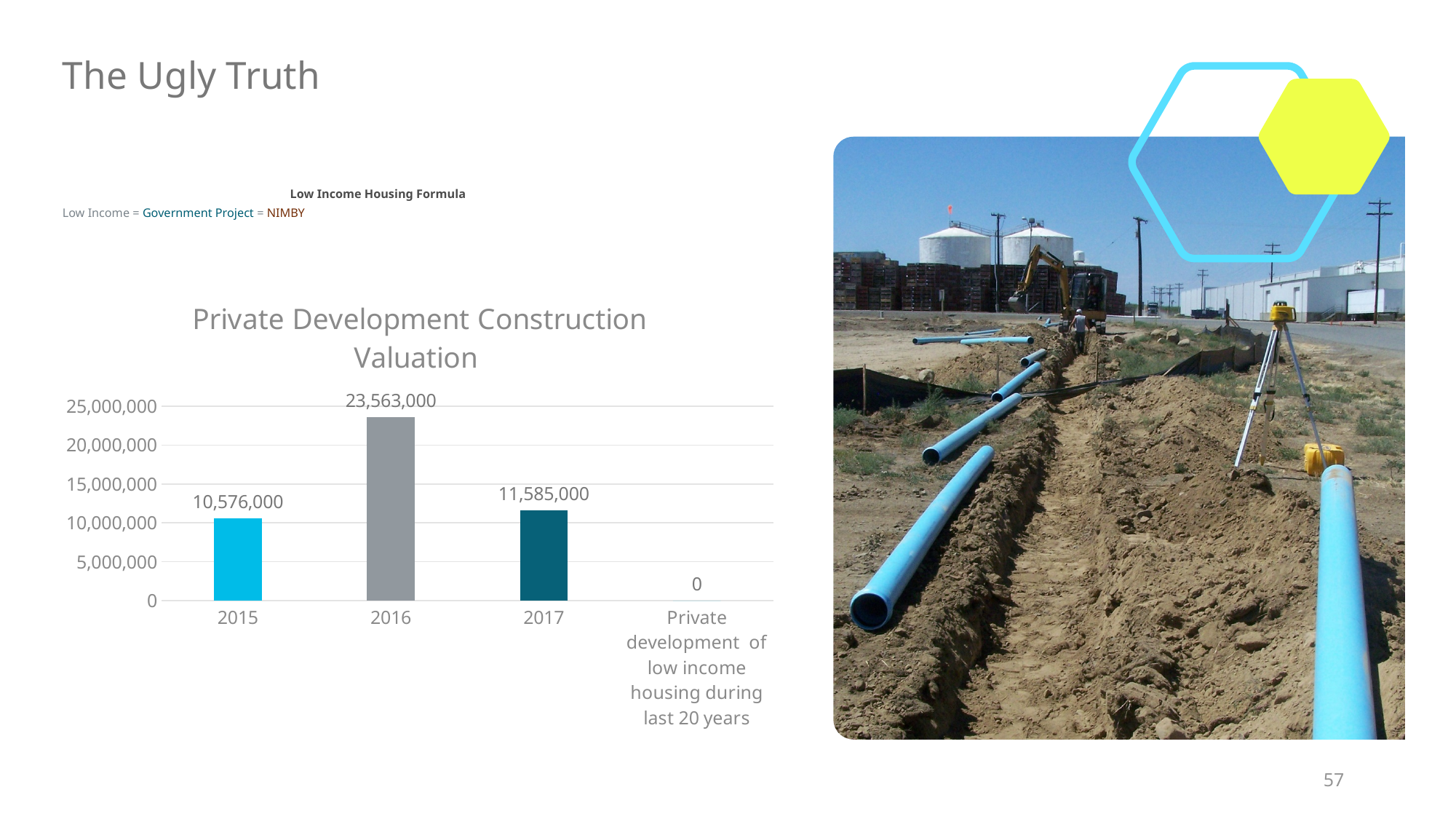
What is the value for 2016 in the Private Development Construction Valuation chart? 23,563,000 What value is shown for private development of low income housing during the last 20 years? 0 What is the value for 2017 in the Private Development Construction Valuation chart? 11,585,000 What kind of chart is the Private Development Construction Valuation chart? Bar chart Which category has the highest value in the Private Development Construction Valuation chart? 2016 What is the value for 2015 in the Private Development Construction Valuation chart? 10,576,000 What is the difference between the 2016 and 2015 values in the Private Development Construction Valuation chart? 12,987,000 How many categories are shown on the x axis of the Private Development Construction Valuation chart? 4 Is the value for 2016 greater or less than 20,000,000? greater What is the difference between the 2017 and 2015 values in the Private Development Construction Valuation chart? 1,009,000 Which is larger in the Private Development Construction Valuation chart, the value for 2015 or the value for 2017? 2017 Which category has the lowest value in the Private Development Construction Valuation chart? Private development of low income housing during last 20 years